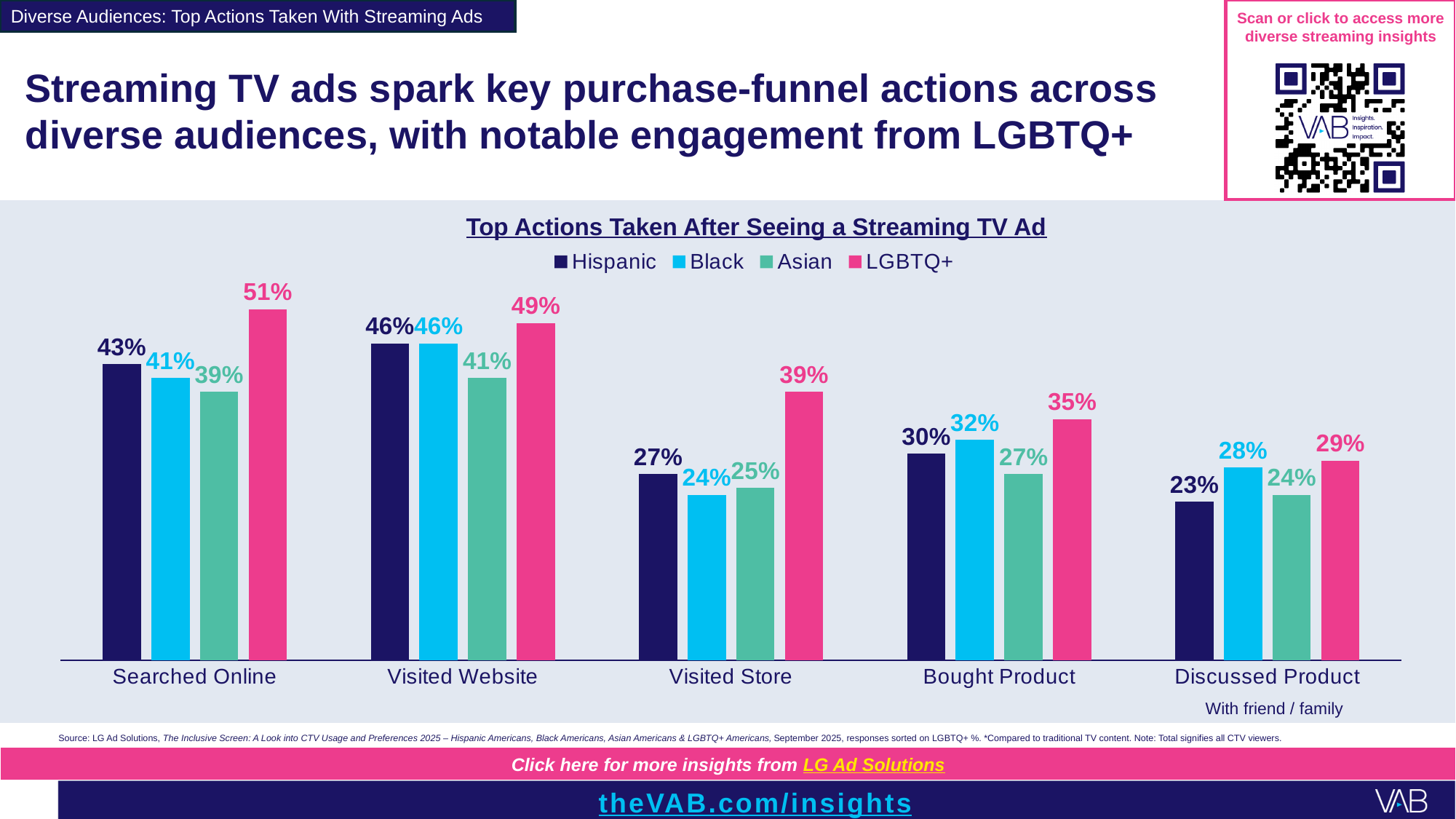
What is the value for Asian respondents in the Visited Website category? 41% Which is larger for Bought Product: the Hispanic value or the Black value? Black What percentage of LGBTQ+ respondents searched online after seeing a streaming TV ad? 51% How many action categories are shown on the x axis? 5 Which audience has the highest value for Visited Store? LGBTQ+ What is the difference between the LGBTQ+ and Black values for Visited Store? 15% Which audience has the lowest value for Discussed Product? Hispanic What is the title of the chart? Top Actions Taken After Seeing a Streaming TV Ad What kind of chart is shown on the slide? Bar chart What is the value for Black respondents in the Bought Product category? 32% Do the LGBTQ+ values rise or fall moving from Searched Online to Discussed Product? Fall How many series does the legend list? 4